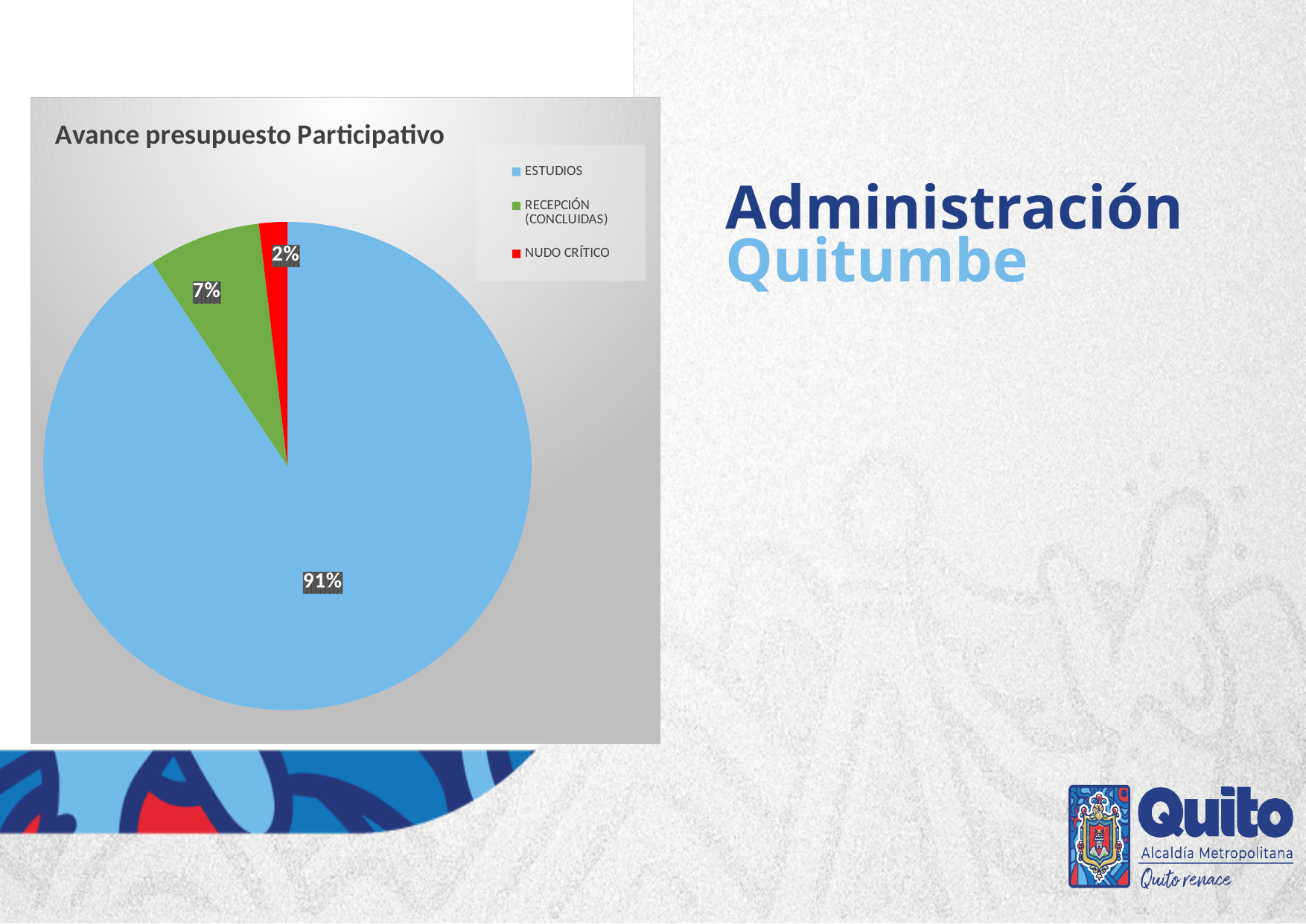
What colour is the slice for NUDO CRÍTICO? red Which category has the smallest share of the pie? NUDO CRÍTICO What type of chart is shown on the slide? pie chart How many categories does the legend list? 3 What percentage of the pie does ESTUDIOS represent? 91% Which category has the largest share of the pie? ESTUDIOS What percentage of the pie does RECEPCIÓN (CONCLUIDAS) represent? 7% What is the difference in percentage points between ESTUDIOS and RECEPCIÓN (CONCLUIDAS)? 84 What is the title of the chart? Avance presupuesto Participativo Which is larger, the share for RECEPCIÓN (CONCLUIDAS) or the share for NUDO CRÍTICO? RECEPCIÓN (CONCLUIDAS) What percentage of the pie does NUDO CRÍTICO represent? 2% What is the difference in percentage points between RECEPCIÓN (CONCLUIDAS) and NUDO CRÍTICO? 5